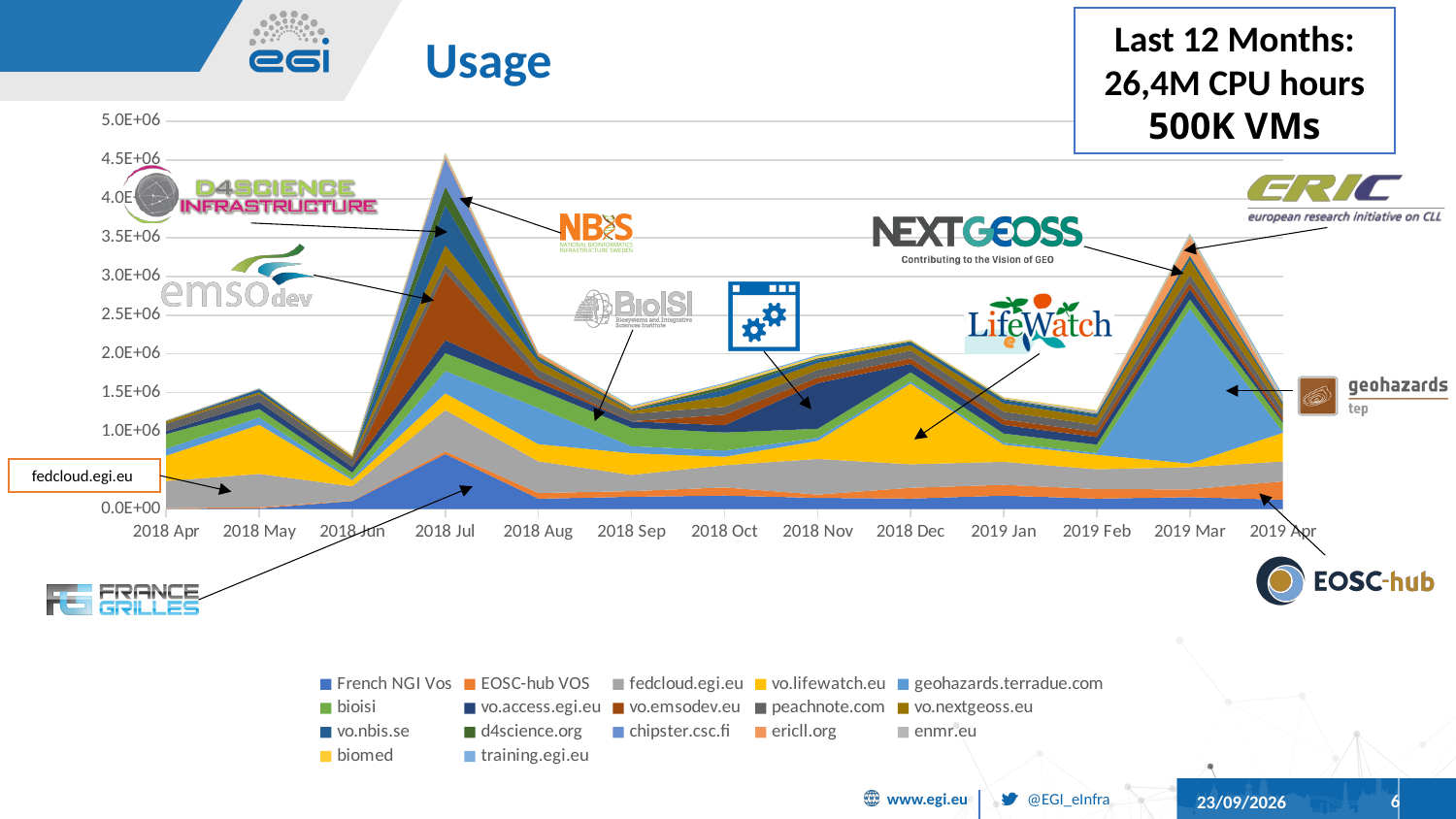
Which month has the larger total usage, 2018 Jul or 2019 Mar? 2018 Jul What kind of chart is shown on the slide? stacked area chart How many series does the legend list? 17 Is the total usage in 2019 Mar greater or less than 3.0E+06? greater How many months are shown along the x axis? 13 In which month is the total usage lowest? 2018 Jun What is the title of the chart? Usage Is the total usage in 2018 Jul greater or less than 4.0E+06? greater Is the total usage in 2018 Jun greater or less than 1.0E+06? less In which month does the total usage reach its highest peak? 2018 Jul What is the highest value shown on the y axis? 5.0E+06 Does the total usage rise or fall from 2018 Jul to 2018 Sep? fall